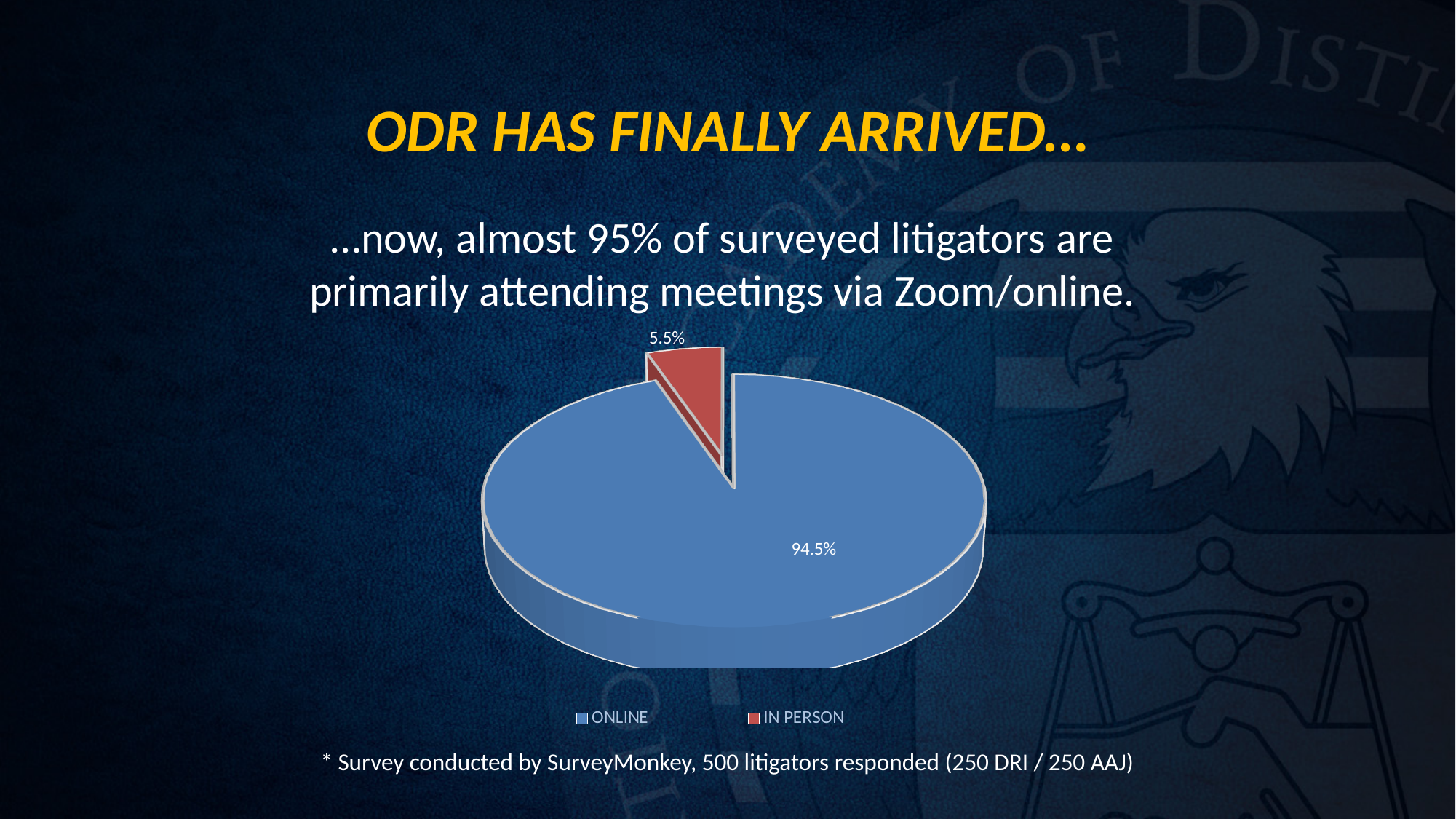
What colour is the IN PERSON slice in the pie chart? Red How many entries does the chart legend list? 2 How many slices does the pie chart have? 2 Which slice of the pie chart is the largest? ONLINE What percentage of the pie chart is labelled IN PERSON? 5.5% What percentage of the pie chart is labelled ONLINE? 94.5% What type of chart is shown on the slide? Pie chart Which slice of the pie chart is the smallest? IN PERSON What colour is the ONLINE slice in the pie chart? Blue What is the difference in percentage points between the ONLINE and IN PERSON slices? 89 percentage points What share of the pie does the IN PERSON slice represent? 5.5% Which is larger, the ONLINE slice or the IN PERSON slice? ONLINE